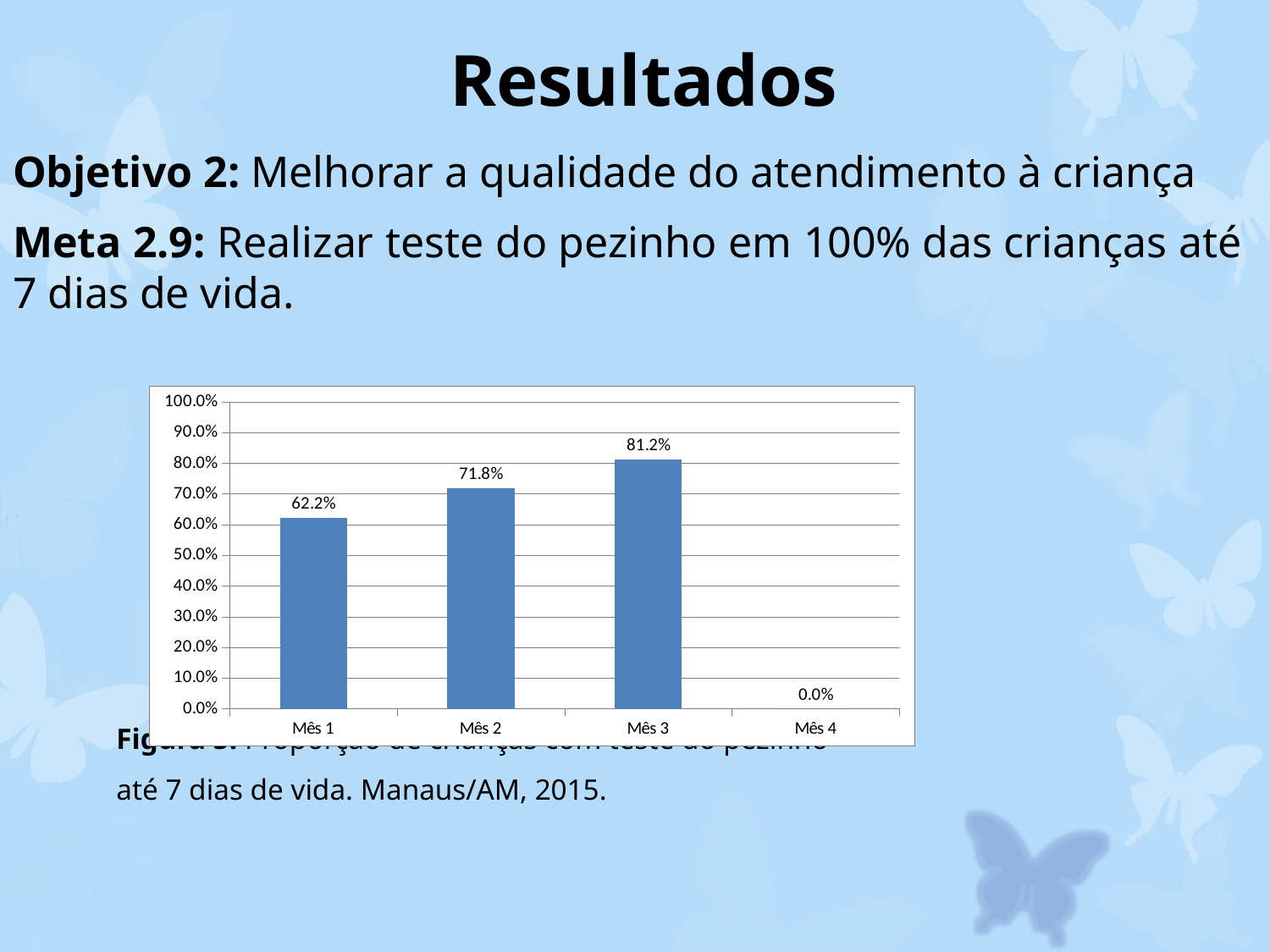
What is the value for Mês 1? 62.2% Which is larger, the value for Mês 2 or the value for Mês 3? Mês 3 What kind of chart is shown on the slide? bar chart Which month has the lowest value? Mês 4 Which month has the highest value? Mês 3 How many months are shown on the x axis? 4 What is the value for Mês 3? 81.2% What is the difference between the values for Mês 2 and Mês 1? 9.6% What is the value for Mês 4? 0.0% Is the value for Mês 1 greater or less than 70.0%? less What is the difference between the values for Mês 3 and Mês 1? 19.0% What is the value for Mês 2? 71.8%